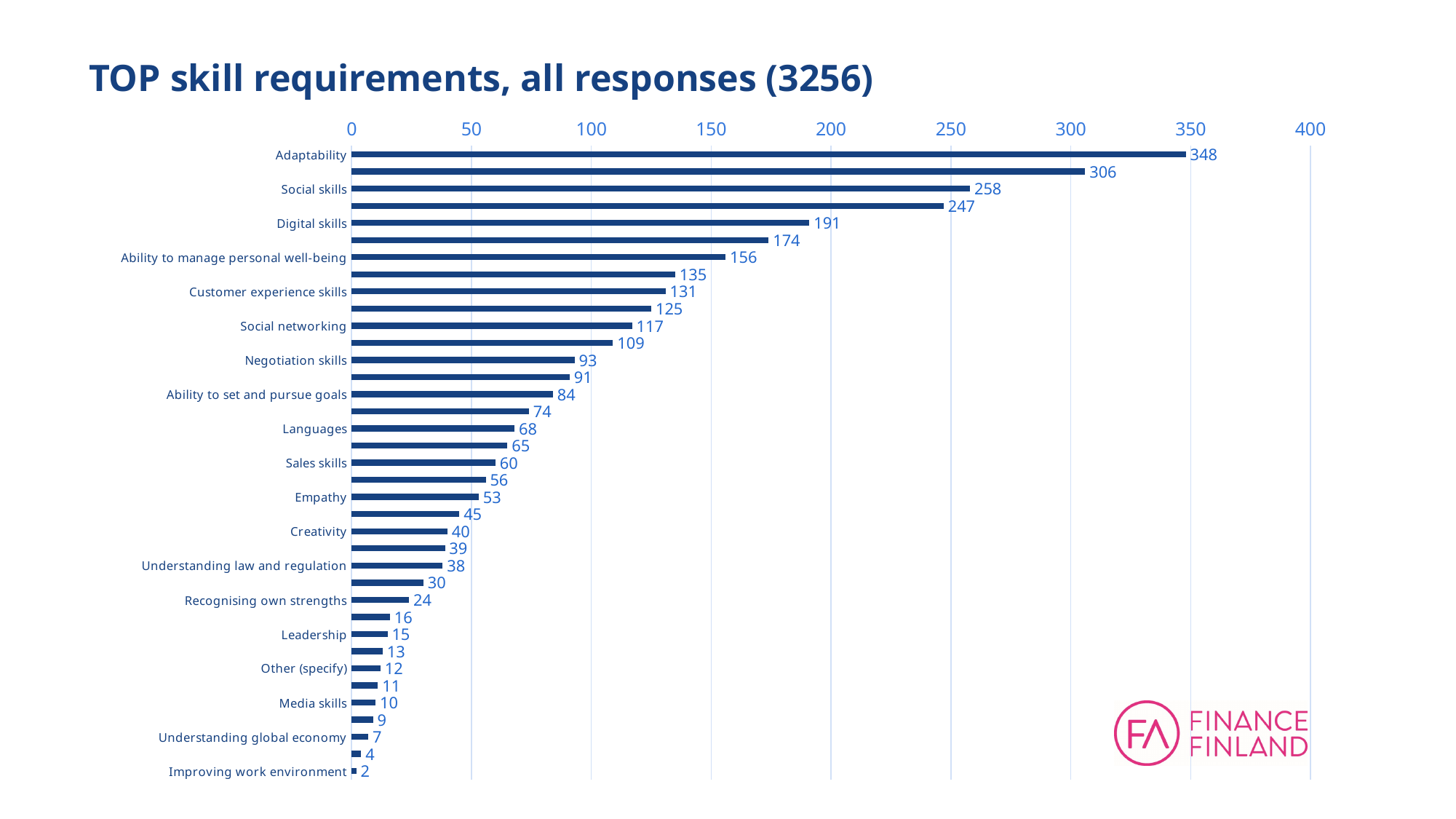
Which category has the highest value? Adaptability Which category has the lowest value? Improving work environment What is the value for Digital skills? 191 What is the difference between the values for Adaptability and Social skills? 90 What is the value for Customer experience skills? 131 Which is larger, the value for Negotiation skills or the value for Languages? Negotiation skills What is the value for Leadership? 15 What is the value for Empathy? 53 What is the value for Adaptability? 348 What is the title of the chart? TOP skill requirements, all responses (3256) Is the value for Ability to manage personal well-being greater or less than 150? greater What type of chart is shown on the slide? Bar chart